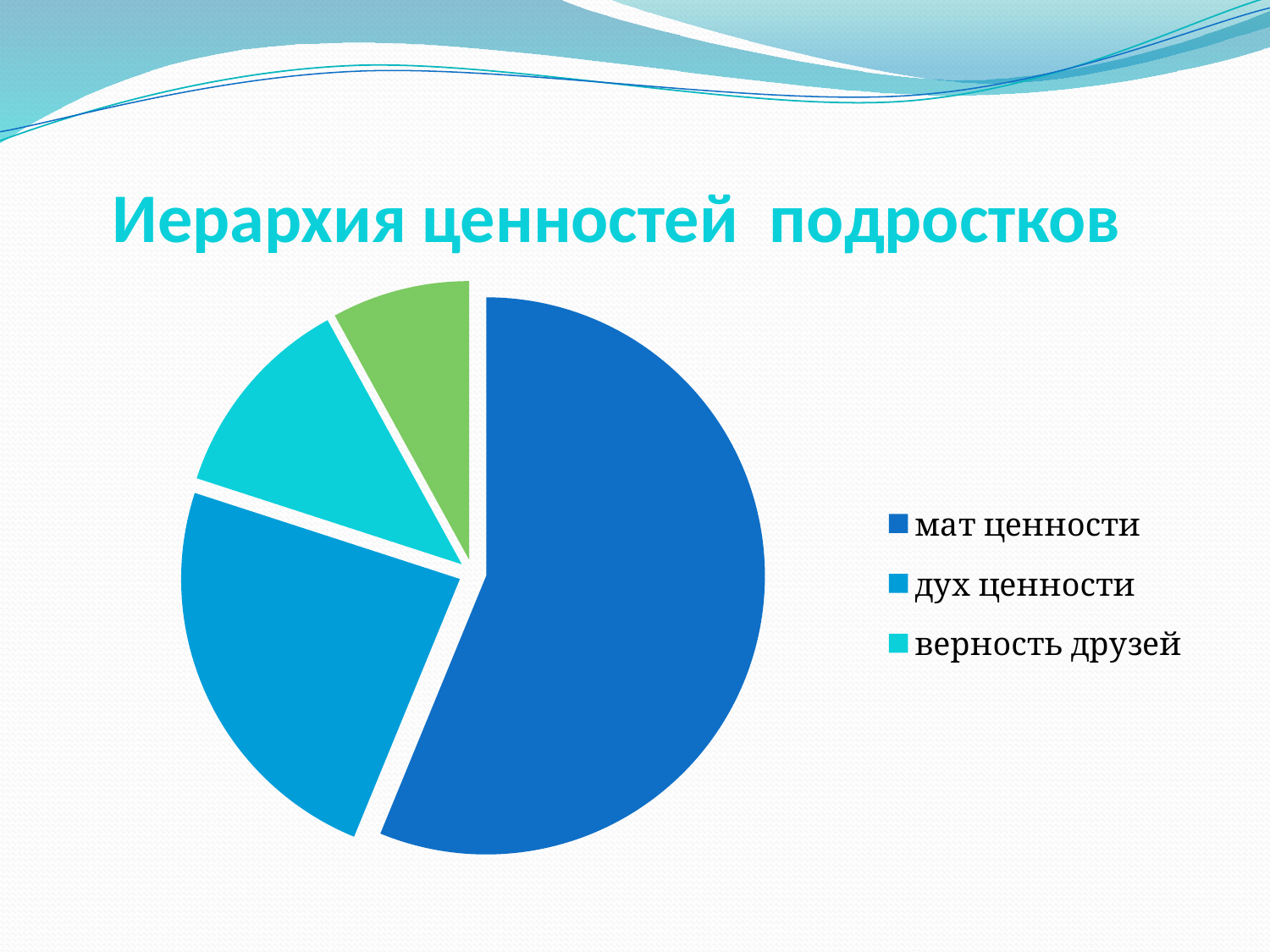
Which slice is larger, мат ценности or дух ценности? мат ценности Which of the three legend categories has the smallest slice of the pie chart? верность друзей How many slices does the pie chart have? 4 Which slice is larger, дух ценности or верность друзей? дух ценности How many entries does the legend of the pie chart list? 3 Which legend category has the largest slice of the pie chart? мат ценности What colour is the slice for мат ценности in the pie chart? dark blue What is the title of the slide with the pie chart? Иерархия ценностей подростков What kind of chart is shown on the slide? pie chart